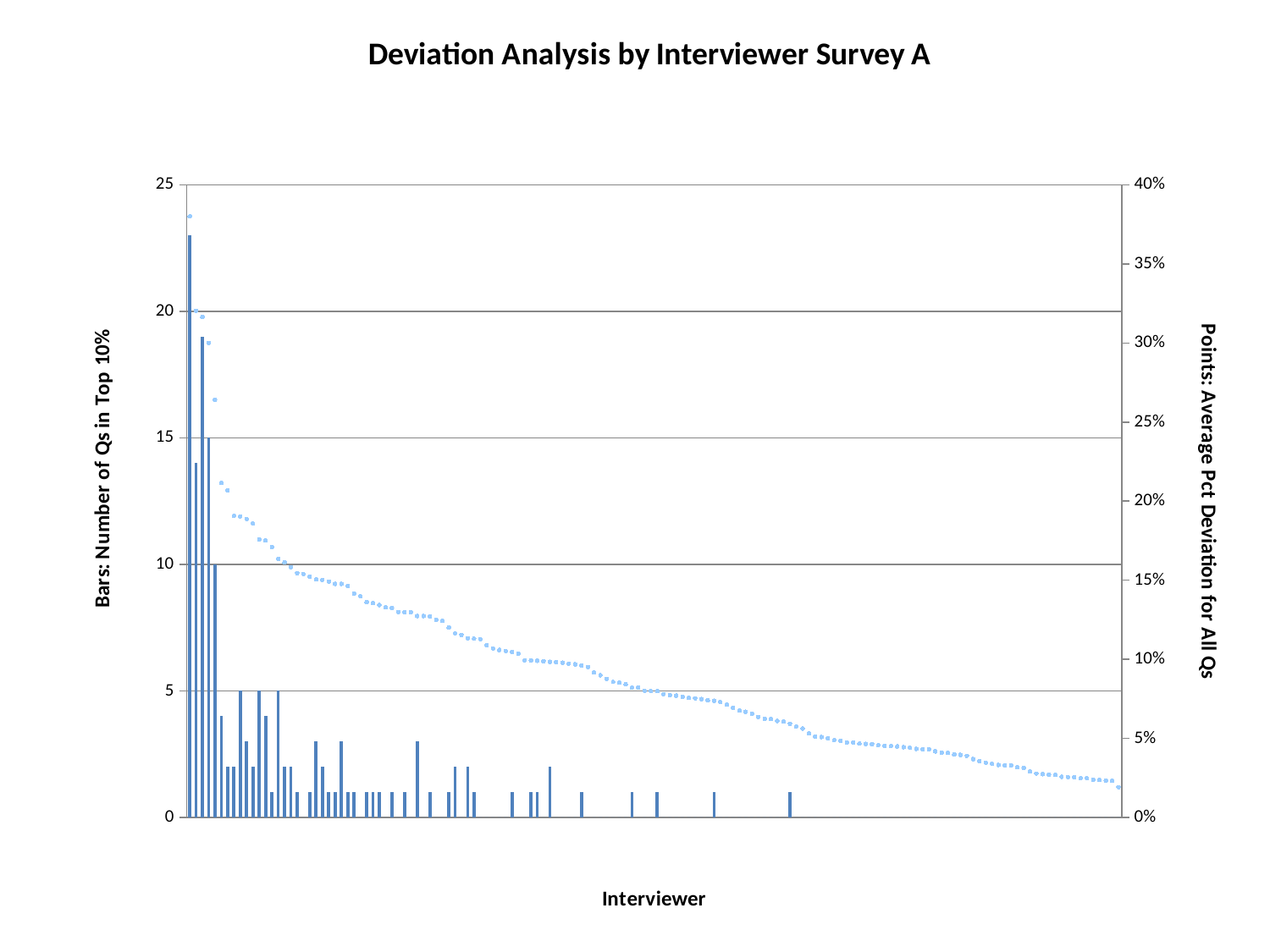
Which is larger, the first bar from the left or the second bar from the left? the first bar What is the title of the right-hand vertical axis? Points: Average Pct Deviation for All Qs Is the value of the tallest bar greater or less than 25? less What is the title of the chart? Deviation Analysis by Interviewer Survey A Is the value of the highest point (leftmost) greater or less than 35%? greater Is the value of the leftmost point greater or less than 30%? greater Do the plotted points rise or fall moving left to right along the x axis? fall What kind of chart is shown on the slide? a bar chart combined with a point (scatter) series